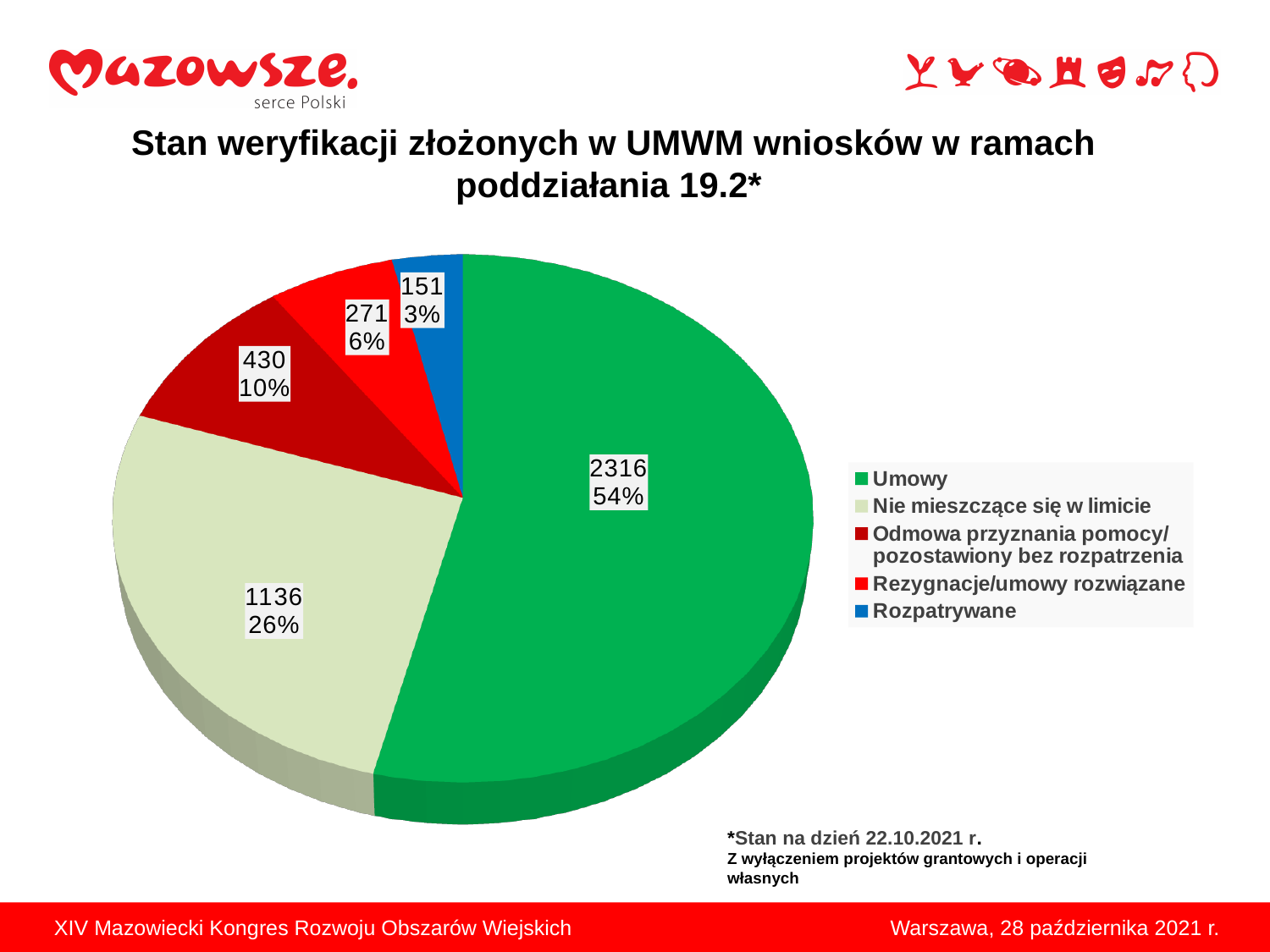
What is the value shown for Umowy? 2316 What kind of chart is shown on the slide? pie chart What is the value shown for Rozpatrywane? 151 What percentage share does the Odmowa przyznania pomocy/pozostawiony bez rozpatrzenia slice have? 10% What is the value shown for Nie mieszczące się w limicie? 1136 What is the difference between the values for Umowy and Nie mieszczące się w limicie? 1180 How many entries does the legend list? 5 What percentage share does the Rezygnacje/umowy rozwiązane slice have? 6% Which category has the smallest slice? Rozpatrywane How many slices does the pie chart have? 5 Which category has the largest slice? Umowy Which is larger, the value for Odmowa przyznania pomocy/pozostawiony bez rozpatrzenia or the value for Rezygnacje/umowy rozwiązane? Odmowa przyznania pomocy/pozostawiony bez rozpatrzenia